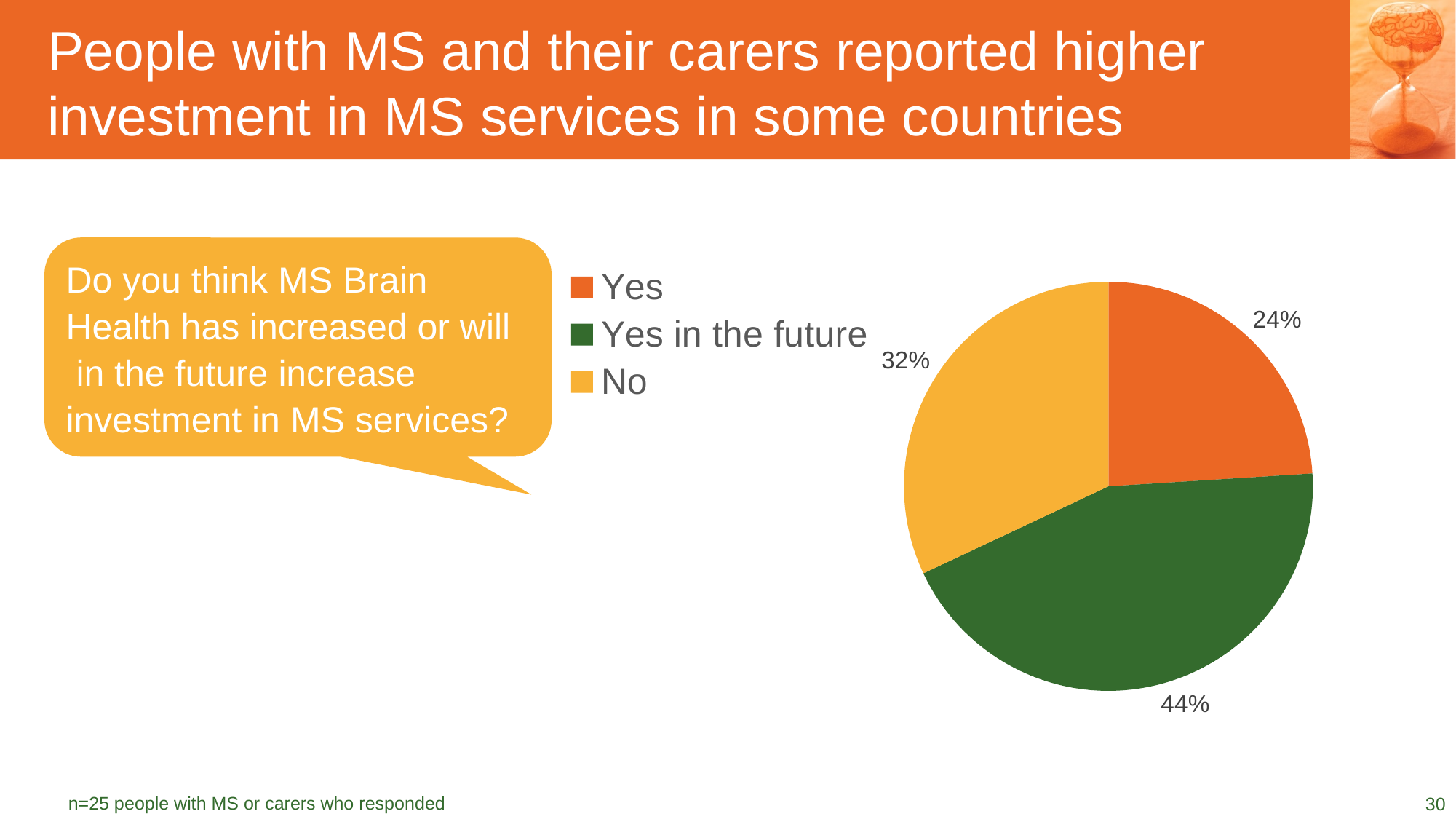
What colour is the "Yes in the future" slice? green What kind of chart is shown on the slide? pie chart Which response has the smallest share of the pie? Yes What is the difference in percentage points between "No" and "Yes"? 8 What percentage of respondents answered "No"? 32% How many slices does the pie chart have? 3 How many entries does the legend list? 3 What is the difference in percentage points between "Yes in the future" and "Yes"? 20 Which is larger, the share for "No" or the share for "Yes"? No What percentage of respondents answered "Yes"? 24% What percentage of respondents answered "Yes in the future"? 44% Which response has the largest share of the pie? Yes in the future